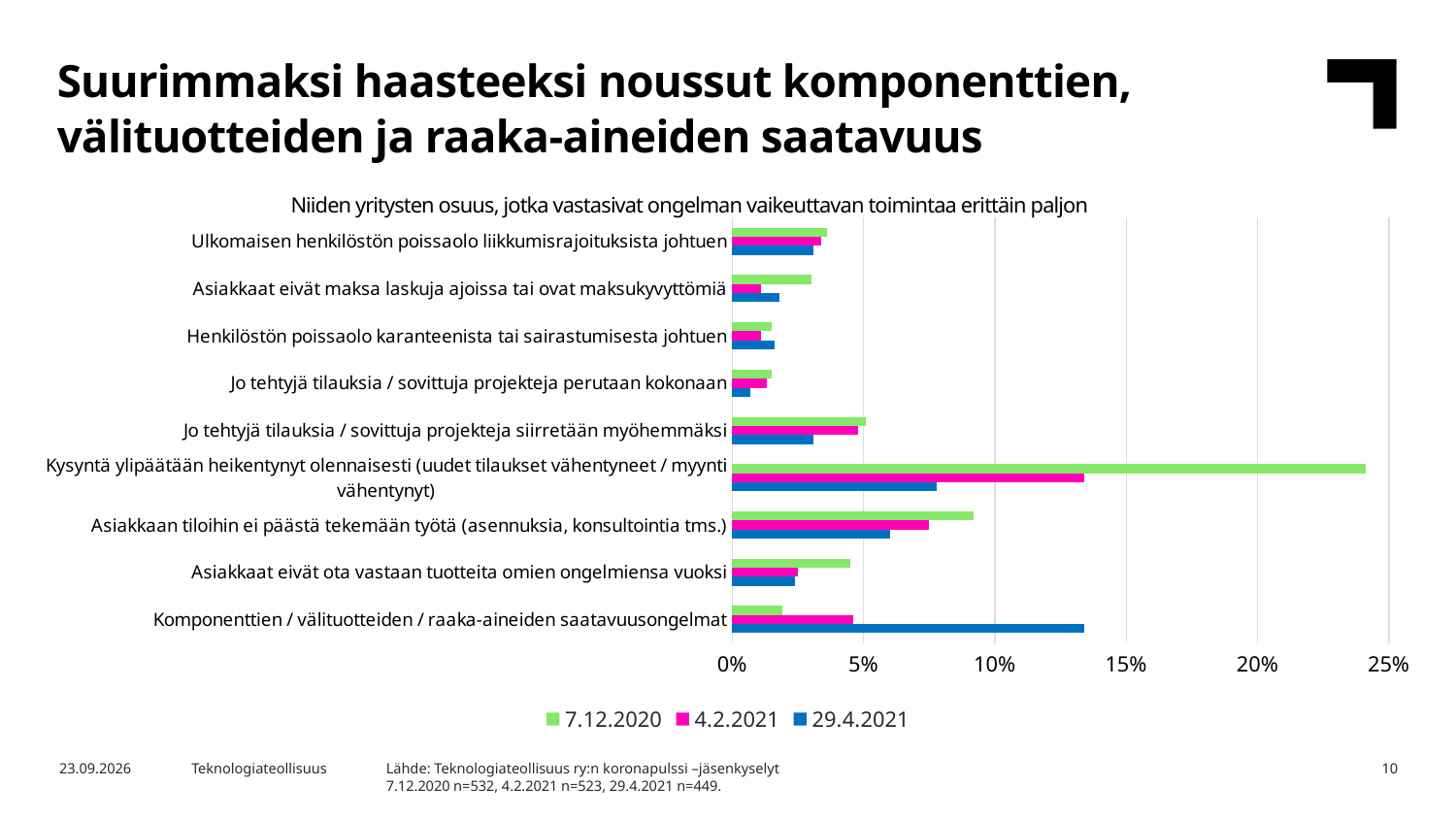
Which category has the highest value for the 29.4.2021 series? Komponenttien / välituotteiden / raaka-aineiden saatavuusongelmat How many categories (problem types) are shown on the chart? 9 Is the 29.4.2021 value for 'Komponenttien / välituotteiden / raaka-aineiden saatavuusongelmat' greater or less than 10%? greater How many series does the legend list? 3 What are the three series listed in the chart legend? 7.12.2020, 4.2.2021, 29.4.2021 Is the 7.12.2020 value for 'Kysyntä ylipäätään heikentynyt olennaisesti' greater or less than 20%? greater Which category has the highest value for the 7.12.2020 series? Kysyntä ylipäätään heikentynyt olennaisesti (uudet tilaukset vähentyneet / myynti vähentynyt) Which category has the lowest value for the 29.4.2021 series? Jo tehtyjä tilauksia / sovittuja projekteja perutaan kokonaan What kind of chart is shown on the slide? Bar chart For 'Kysyntä ylipäätään heikentynyt olennaisesti', which series has the larger value: 7.12.2020 or 4.2.2021? 7.12.2020 Is the 7.12.2020 value for 'Asiakkaan tiloihin ei päästä tekemään työtä' greater or less than 10%? less For 'Komponenttien / välituotteiden / raaka-aineiden saatavuusongelmat', which series has the larger value: 7.12.2020 or 29.4.2021? 29.4.2021